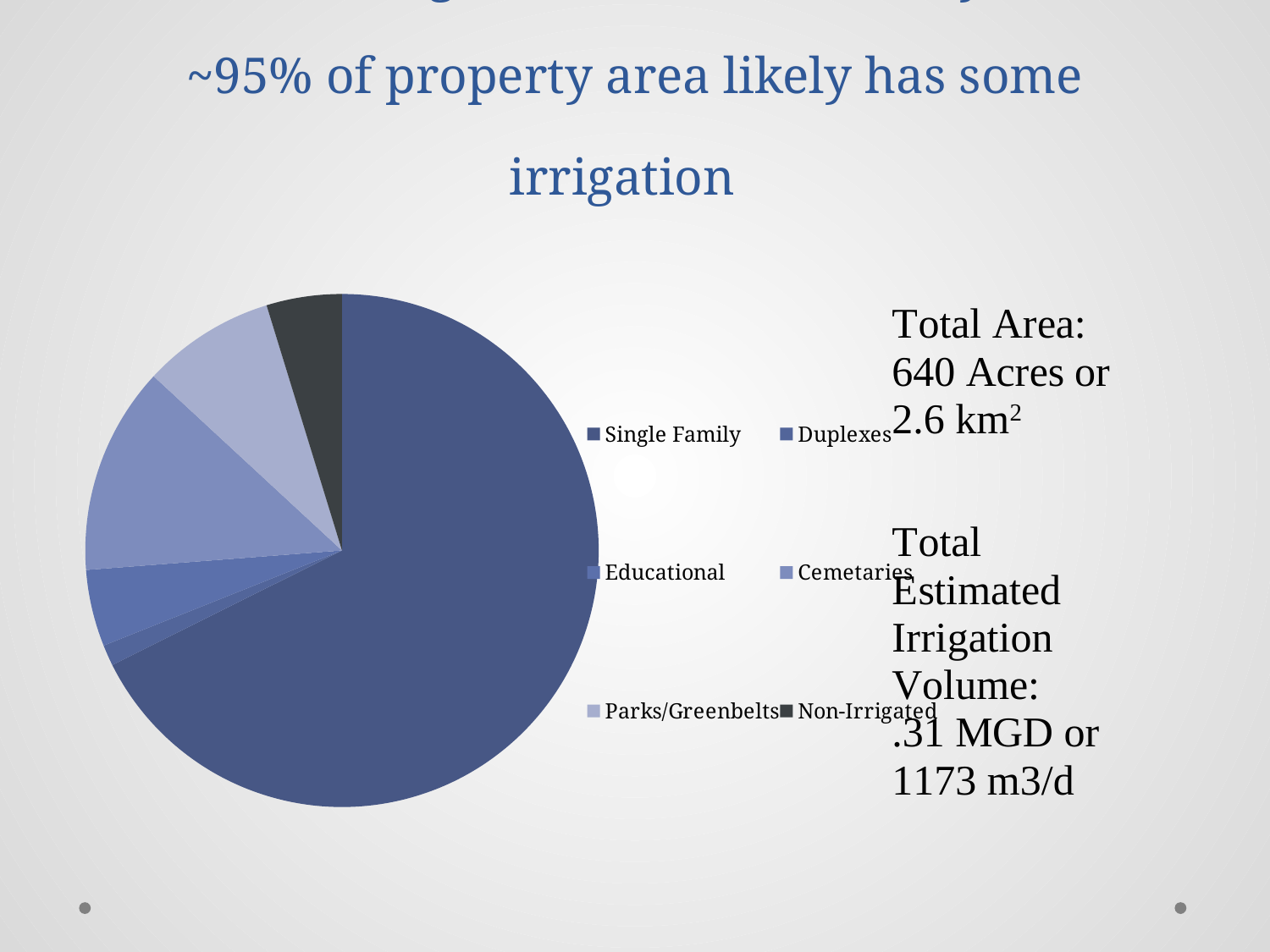
Which legend entry appears immediately after Single Family in the legend? Duplexes Which category has the largest slice of the pie chart? Single Family Which slice is larger, Educational or Duplexes? Educational Does the Single Family slice take up more or less than half of the pie? more Which slice is larger, Single Family or Parks/Greenbelts? Single Family What kind of chart is shown on the slide? pie chart Which legend entry is shown in dark grey? Non-Irrigated Which slice is larger, Single Family or Educational? Single Family How many categories does the pie chart's legend list? 6